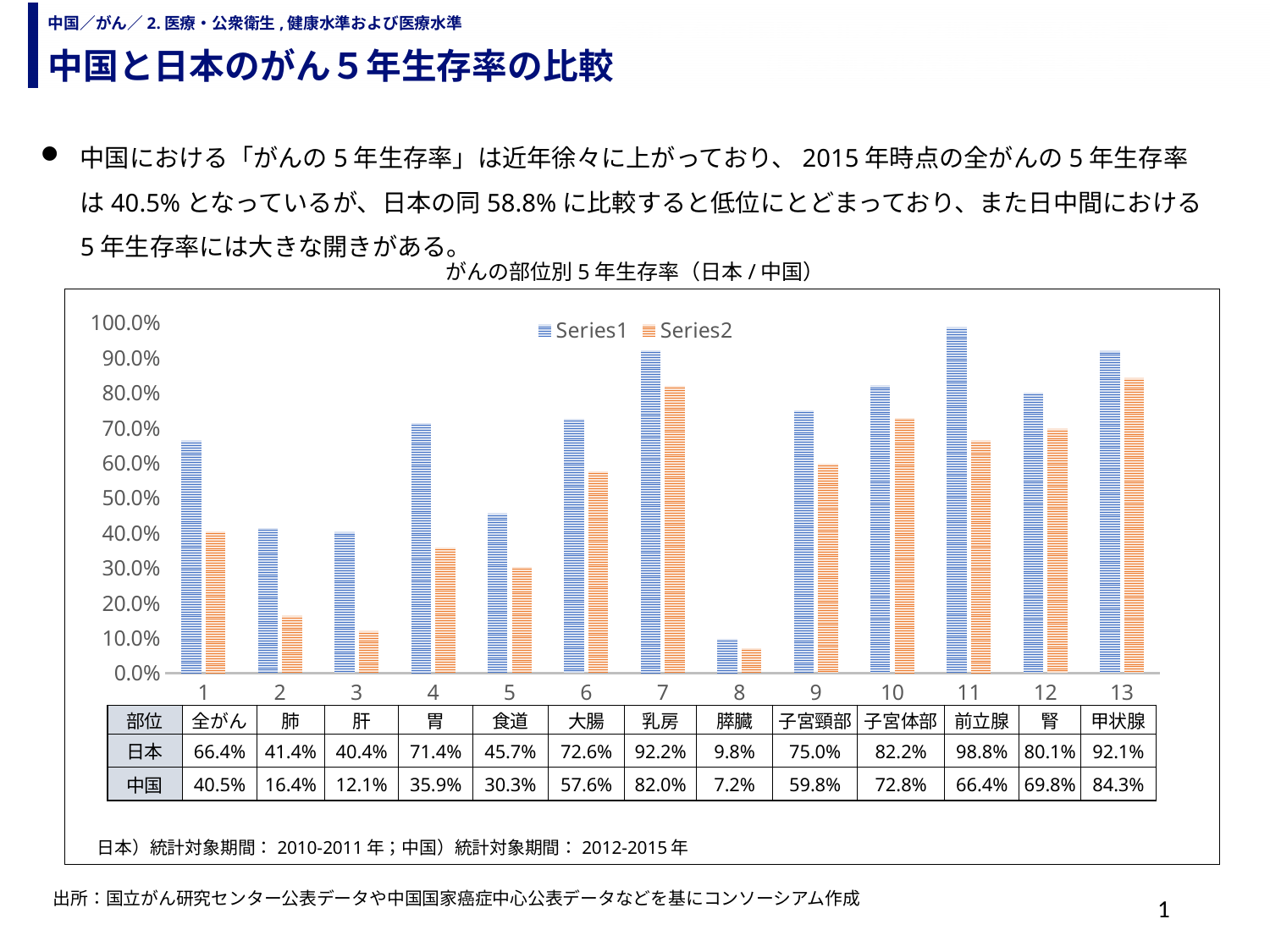
How many series does the legend list? 2 Which is larger, the 中国 rate for 甲状腺 or the 中国 rate for 乳房? 甲状腺 Which cancer site has the highest 5-year survival rate for 日本? 前立腺 What is the difference between the 日本 and 中国 5-year survival rates for 肺? 25.0% How many cancer sites (categories) are plotted on the x axis? 13 What type of chart is shown on the slide? bar chart What is the 5-year survival rate for 中国 for 肝? 12.1% Which cancer site has the lowest 5-year survival rate for 中国? 膵臓 Is the 日本 value for 胃 greater or less than 70.0%? greater What is the 5-year survival rate for 中国 for 全がん? 40.5% What is the title of the chart? がんの部位別５年生存率（日本 / 中国） What is the 5-year survival rate for 日本 for 乳房? 92.2%